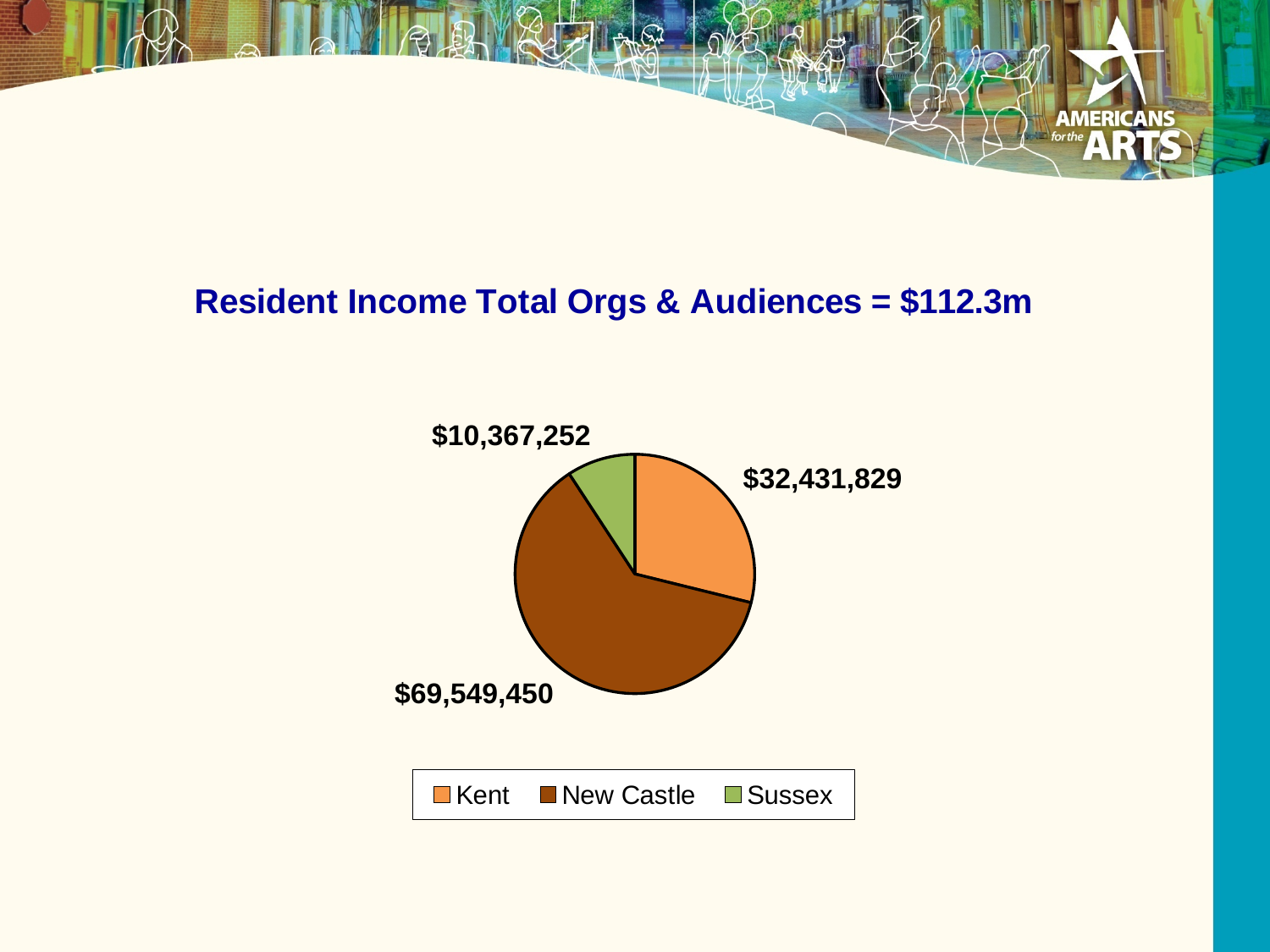
Which county has the smallest slice of the pie chart? Sussex What is the difference between the values for New Castle and Kent? $37,117,621 What is the title of the chart on the slide? Resident Income Total Orgs & Audiences = $112.3m Which is larger, the value for Kent or the value for Sussex? Kent How many slices does the pie chart have? 3 What kind of chart is shown on the slide? Pie chart What is the value for New Castle in the pie chart? $69,549,450 Which county is shown in green in the pie chart? Sussex What is the difference between the values for Kent and Sussex? $22,064,577 What is the value for Sussex in the pie chart? $10,367,252 Which county has the largest slice of the pie chart? New Castle What is the value for Kent in the pie chart? $32,431,829